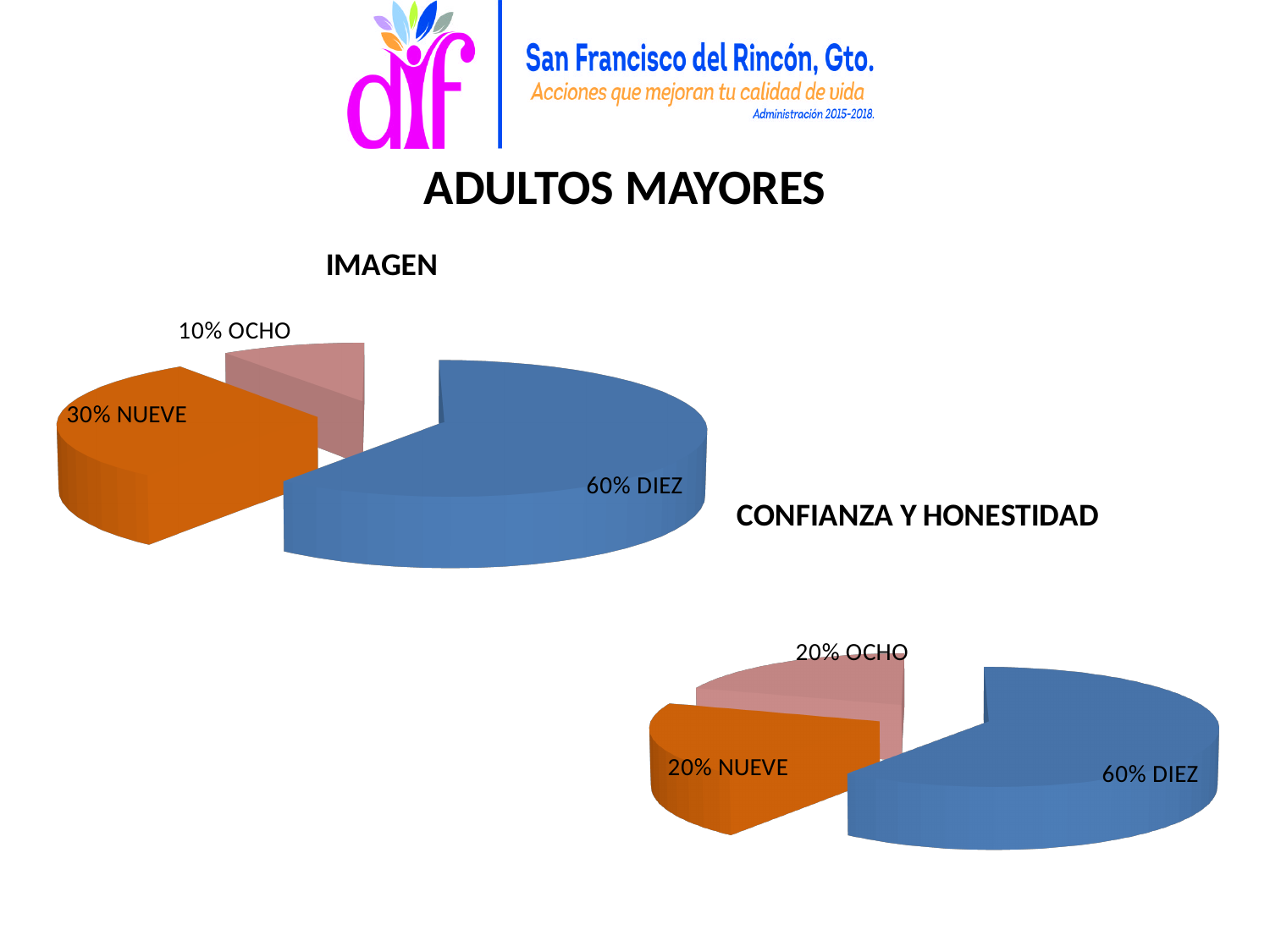
In the CONFIANZA Y HONESTIDAD chart, what share does OCHO have? 20% In the IMAGEN chart, what share does OCHO have? 10% In the CONFIANZA Y HONESTIDAD chart, what share does DIEZ have? 60% In the IMAGEN chart, which is larger, NUEVE or OCHO? NUEVE In the IMAGEN chart, which category has the largest slice? DIEZ In the IMAGEN chart, which category has the smallest slice? OCHO In the CONFIANZA Y HONESTIDAD chart, how many slices does the pie have? 3 What kind of chart is the IMAGEN chart? Pie chart In the CONFIANZA Y HONESTIDAD chart, which category has the largest slice? DIEZ In the IMAGEN chart, what is the difference in percentage points between NUEVE and OCHO? 20 In the IMAGEN chart, what share does NUEVE have? 30% In the IMAGEN chart, what share does DIEZ have? 60%